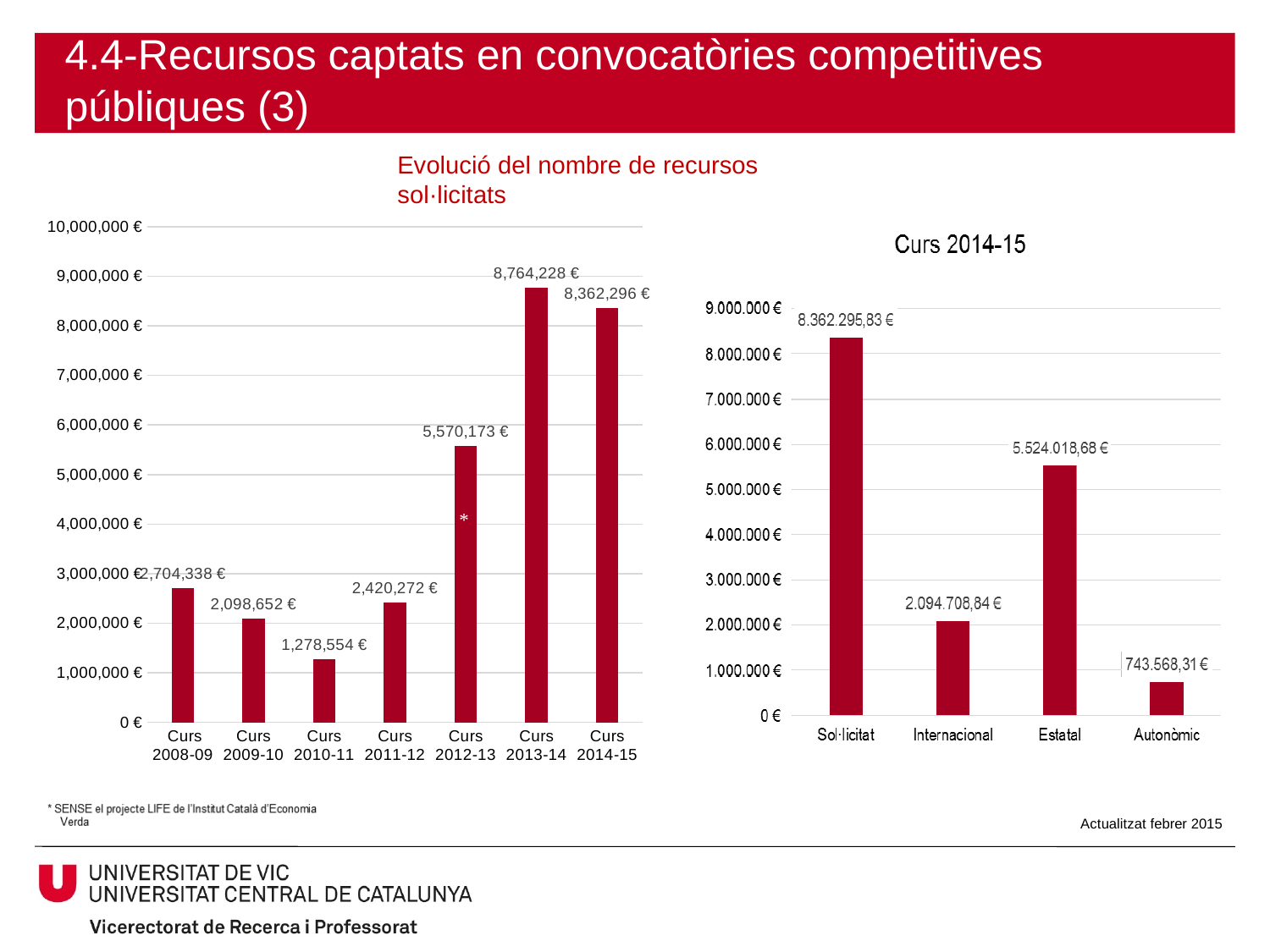
In the chart 'Evolució del nombre de recursos sol·licitats', what is the difference between Curs 2013-14 and Curs 2014-15? 401,932 € In the chart 'Evolució del nombre de recursos sol·licitats', what is the value for Curs 2012-13? 5,570,173 € In the chart 'Curs 2014-15', what is the value for Autonòmic? 743.568,31 € What type of chart is the 'Curs 2014-15' chart? Bar chart In the chart 'Evolució del nombre de recursos sol·licitats', which course year has the highest value? Curs 2013-14 In the chart 'Evolució del nombre de recursos sol·licitats', which course year has the lowest value? Curs 2010-11 In the chart 'Curs 2014-15', what is the value for Estatal? 5.524.018,68 € In the chart 'Evolució del nombre de recursos sol·licitats', what is the value for Curs 2010-11? 1,278,554 € In the chart 'Evolució del nombre de recursos sol·licitats', which is larger: Curs 2008-09 or Curs 2011-12? Curs 2008-09 In the chart 'Curs 2014-15', how many categories are shown? 4 In the chart 'Evolució del nombre de recursos sol·licitats', how many course years are shown? 7 In the chart 'Curs 2014-15', which category has the lowest value? Autonòmic